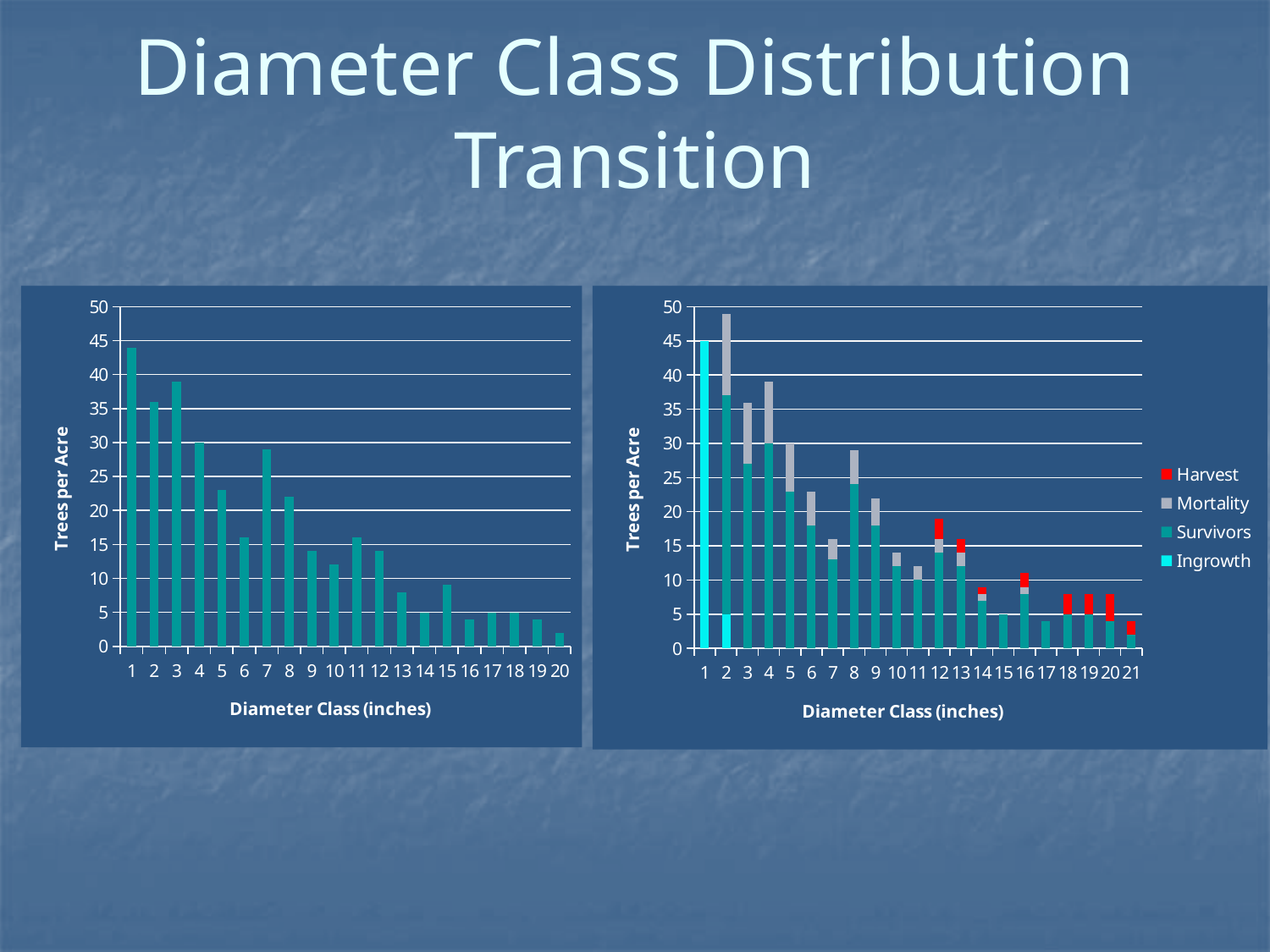
In the left chart, is the value for diameter class 1 greater or less than 40? greater In the left chart, is the value for diameter class 7 greater or less than 25? greater How many diameter classes are shown on the x axis of the right chart? 21 In the right chart, which series is shown in red in the legend? Harvest In the left chart, which has more trees per acre, diameter class 1 or diameter class 2? diameter class 1 What kind of chart is the chart on the left of the slide? bar chart How many diameter classes are shown on the x axis of the left chart? 20 In the left chart, do the values generally rise or fall as the diameter class increases? fall In the left chart, is the value for diameter class 16 greater or less than 5? less How many series does the legend of the right chart list? 4 In the left chart, which diameter class has the lowest number of trees per acre? 20 In the left chart, which diameter class has the highest number of trees per acre? 1